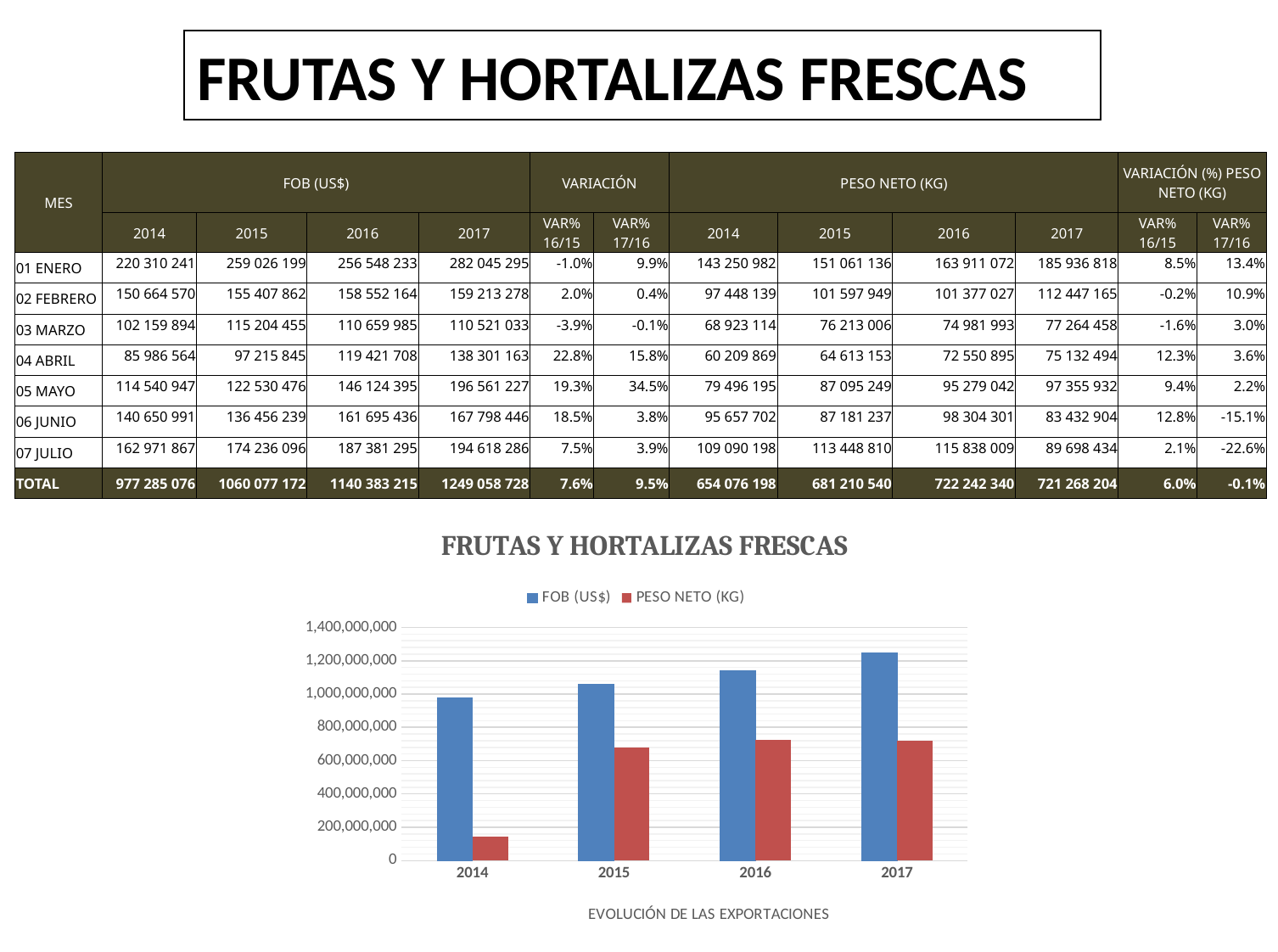
What kind of chart is shown below the table? Bar chart In the chart, is the FOB (US$) value for 2017 greater or less than 1,200,000,000? greater How many series does the legend of the chart list? 2 In the chart, which year has the highest FOB (US$) bar? 2017 In the chart, is the FOB (US$) value for 2014 greater or less than 1,000,000,000? less In the chart, which is larger for 2016: FOB (US$) or PESO NETO (KG)? FOB (US$) In the chart, is the PESO NETO (KG) value for 2014 greater or less than 200,000,000? less In the chart, do the FOB (US$) bars rise or fall from 2014 to 2017? Rise What is the title of the chart? FRUTAS Y HORTALIZAS FRESCAS In the chart, which year has the lowest PESO NETO (KG) bar? 2014 How many years are shown on the x axis of the chart? 4